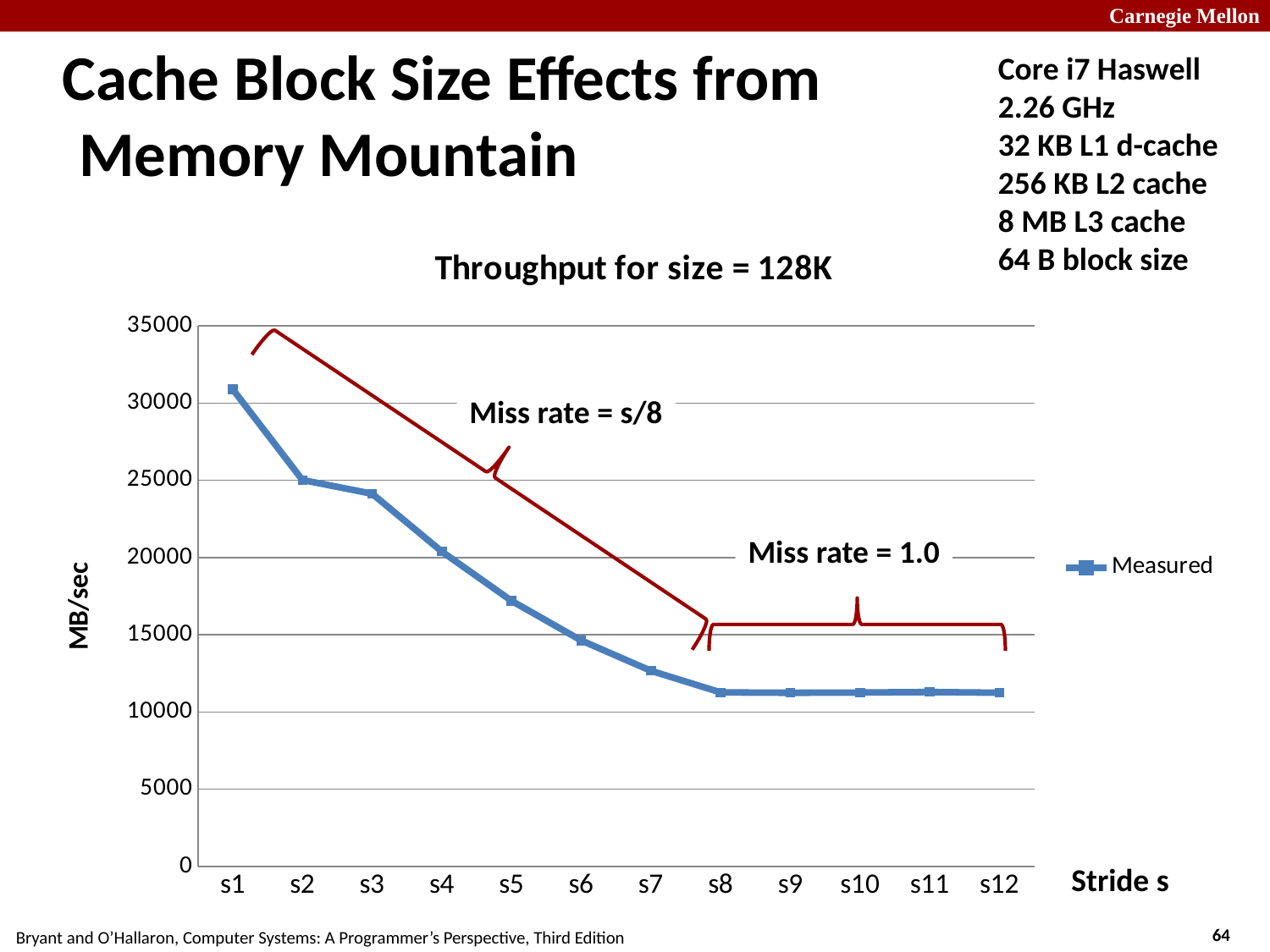
Do the measured values rise or fall as the stride increases from s1 to s8? fall Is the measured value for s1 greater or less than 30000? greater Is the measured value for s10 greater or less than 10000? greater How many series does the legend list? 1 Which has the larger measured throughput, s3 or s7? s3 What is the name of the series in the legend? Measured How many stride categories are plotted on the x axis? 12 What kind of chart is shown on the slide? line chart What is the title of the chart? Throughput for size = 128K Which stride has the highest measured throughput? s1